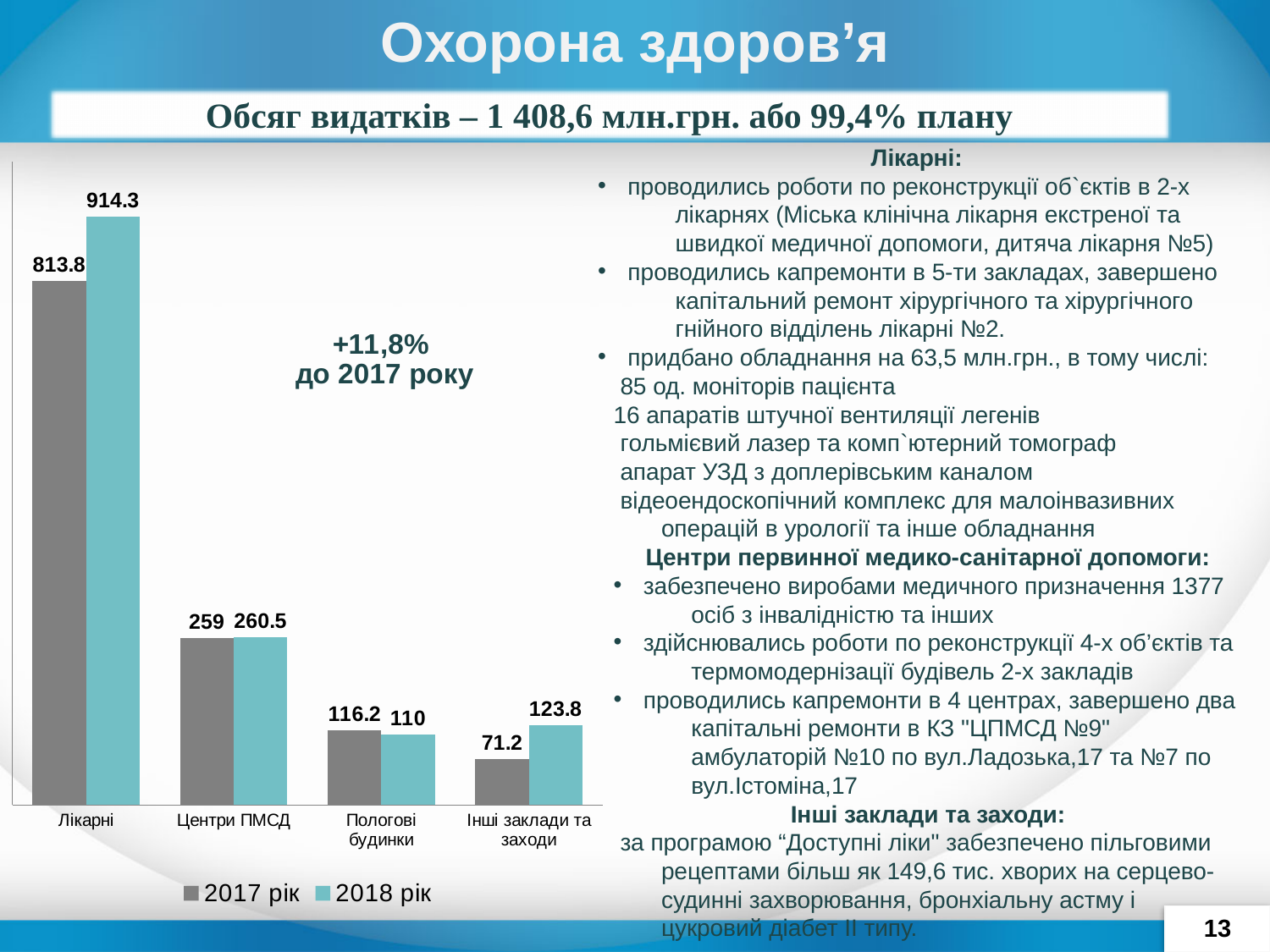
What is the difference between the 2018 рік and 2017 рік values for Інші заклади та заходи? 52.6 How many series does the chart legend list? 2 What is the value for Лікарні in the 2018 рік series? 914.3 What is the value for Пологові будинки in the 2018 рік series? 110 Which category has the lowest value in the 2017 рік series? Інші заклади та заходи How many categories are shown on the x axis of the chart? 4 What is the value for Інші заклади та заходи in the 2017 рік series? 71.2 For Пологові будинки, which series has the larger value, 2017 рік or 2018 рік? 2017 рік Which category has the highest value in the 2018 рік series? Лікарні What is the value for Лікарні in the 2017 рік series? 813.8 What kind of chart is shown on the slide? bar chart What is the difference between the 2018 рік and 2017 рік values for Лікарні? 100.5